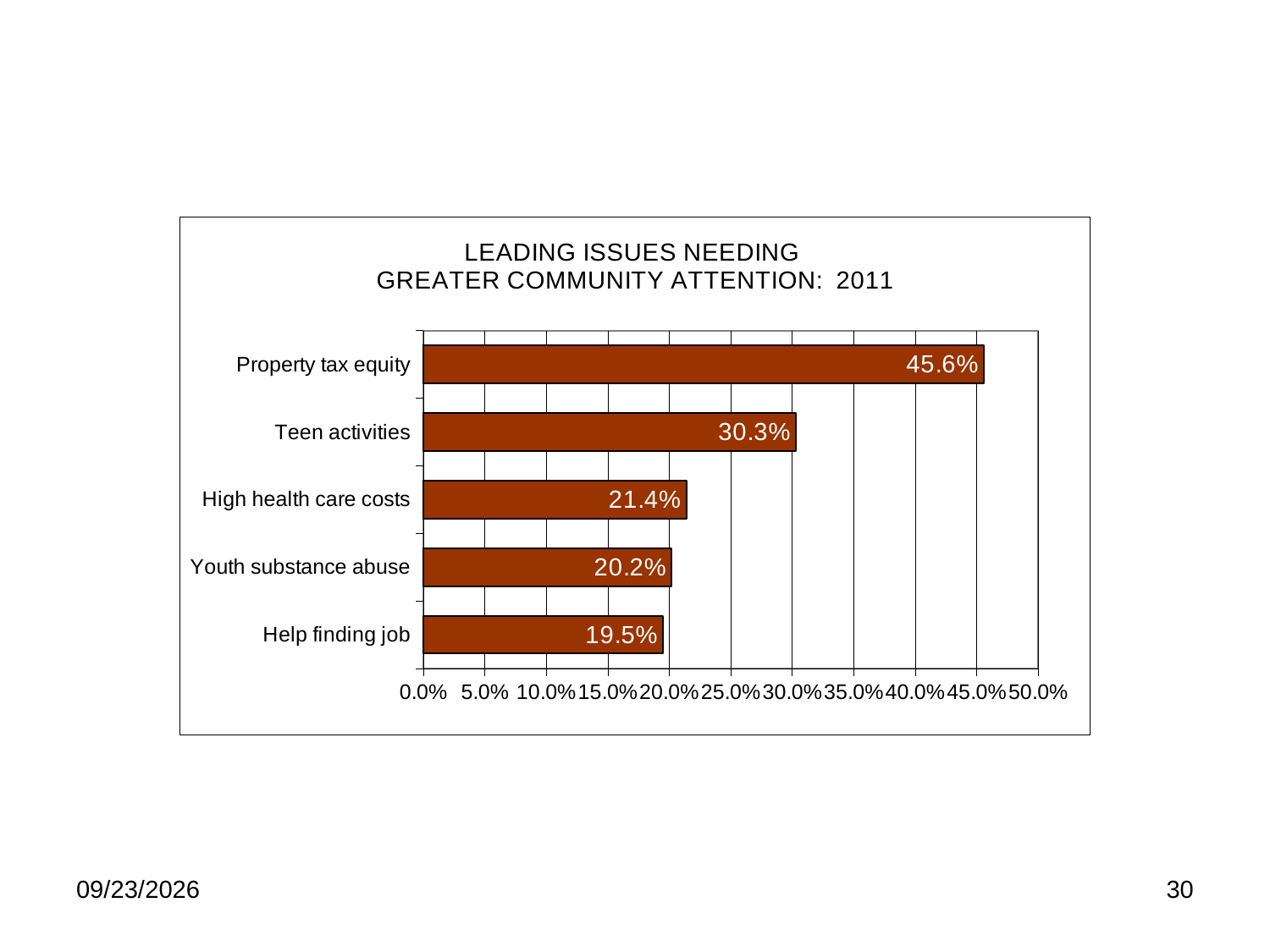
Is the value for Youth substance abuse greater or less than 25.0%? less What is the value for Help finding job? 19.5% Which is larger, the value for Teen activities or the value for High health care costs? Teen activities What is the value for Property tax equity? 45.6% Which issue has the lowest value? Help finding job Which issue has the highest value? Property tax equity What is the value for Teen activities? 30.3% What is the value for High health care costs? 21.4% What is the difference between the values for Youth substance abuse and Help finding job? 0.7% How many issues are shown in the chart? 5 What is the difference between the values for Property tax equity and Teen activities? 15.3% What kind of chart is shown on the slide? Bar chart